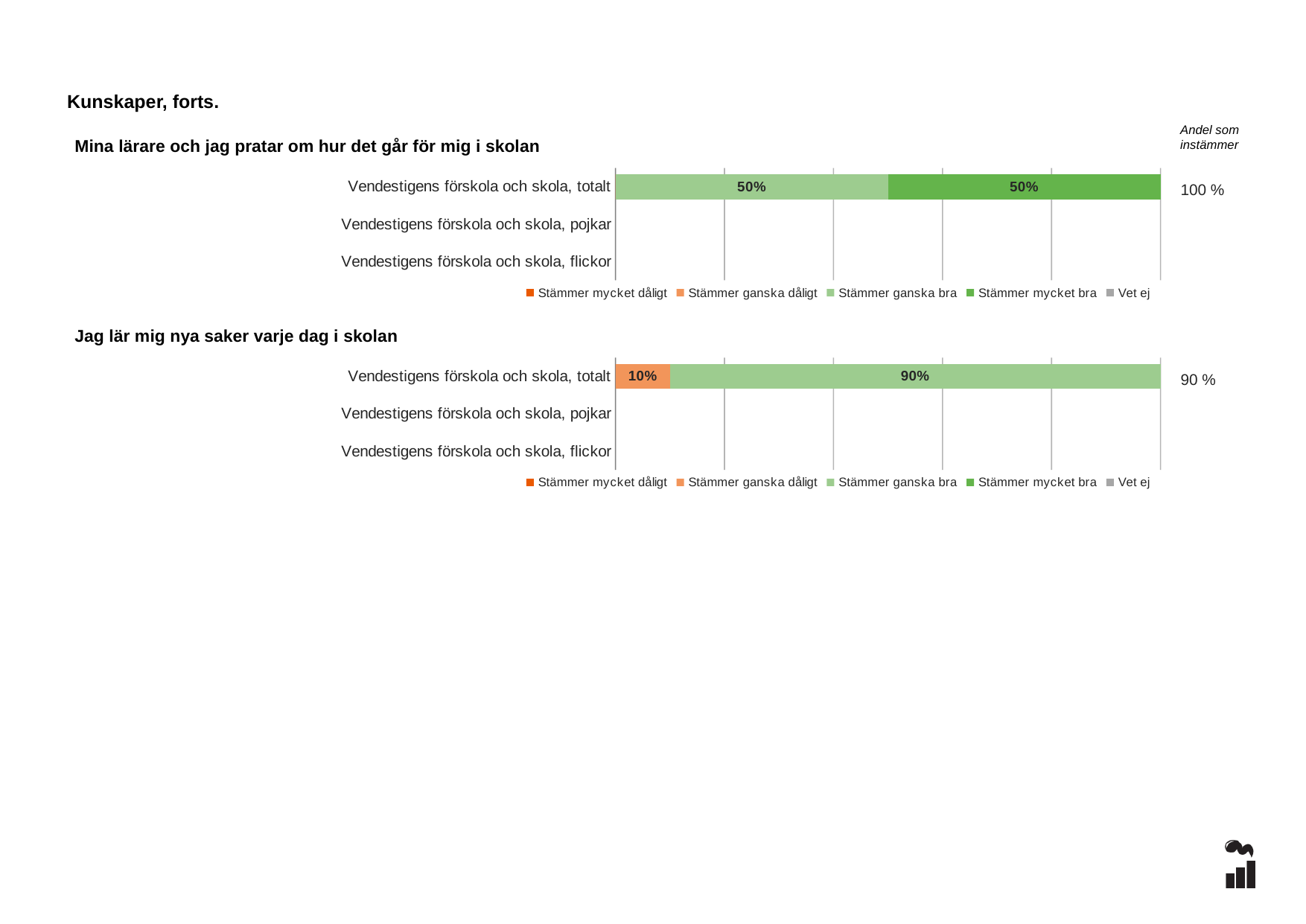
In the chart 'Mina lärare och jag pratar om hur det går för mig i skolan', what is the value for 'Stämmer ganska bra' for Vendestigens förskola och skola, totalt? 50% In the chart 'Jag lär mig nya saker varje dag i skolan', what is the difference between the 'Stämmer ganska bra' and 'Stämmer ganska dåligt' values for Vendestigens förskola och skola, totalt? 80% How many categories are shown on the y axis of the chart 'Mina lärare och jag pratar om hur det går för mig i skolan'? 3 In the chart 'Mina lärare och jag pratar om hur det går för mig i skolan', what is the value for 'Stämmer mycket bra' for Vendestigens förskola och skola, totalt? 50% In the chart 'Jag lär mig nya saker varje dag i skolan', which is larger for Vendestigens förskola och skola, totalt: 'Stämmer ganska dåligt' or 'Stämmer ganska bra'? Stämmer ganska bra In the chart 'Jag lär mig nya saker varje dag i skolan', what is the value for 'Stämmer ganska bra' for Vendestigens förskola och skola, totalt? 90% In the chart 'Jag lär mig nya saker varje dag i skolan', what is the 'Andel som instämmer' value shown for Vendestigens förskola och skola, totalt? 90 % What kind of chart is 'Jag lär mig nya saker varje dag i skolan'? Stacked bar chart In the chart 'Mina lärare och jag pratar om hur det går för mig i skolan', what is the total of the stacked bar for Vendestigens förskola och skola, totalt? 100% How many series does the legend of the chart 'Jag lär mig nya saker varje dag i skolan' list? 5 In the chart 'Jag lär mig nya saker varje dag i skolan', what is the value for 'Stämmer ganska dåligt' for Vendestigens förskola och skola, totalt? 10% In the chart 'Mina lärare och jag pratar om hur det går för mig i skolan', what is the 'Andel som instämmer' value shown for Vendestigens förskola och skola, totalt? 100 %